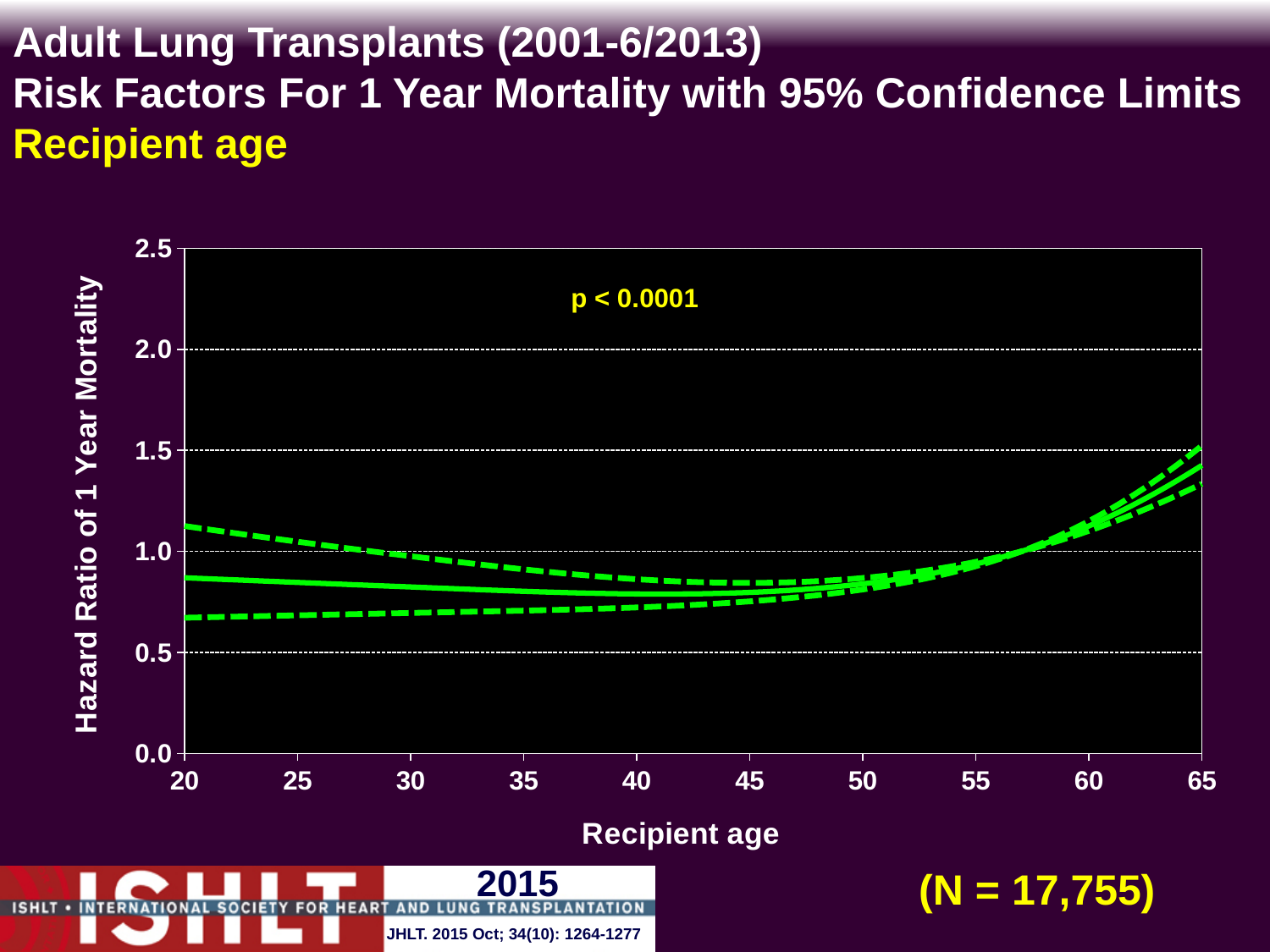
What is the label of the x axis? Recipient age Does the hazard ratio (solid line) rise or fall between recipient age 20 and 40? fall Is the hazard ratio (solid line) larger at recipient age 65 or at recipient age 20? 65 Is the hazard ratio (solid line) at recipient age 20 greater or less than 1.0? less What is the label of the y axis? Hazard Ratio of 1 Year Mortality Is the upper confidence limit (upper dashed line) at recipient age 20 greater or less than 1.0? greater Is the hazard ratio (solid line) at recipient age 40 greater or less than 1.0? less What kind of chart is shown on the slide? line chart Does the hazard ratio (solid line) rise or fall between recipient age 55 and 65? rise Which recipient age shown on the x axis has the highest hazard ratio (solid line)? 65